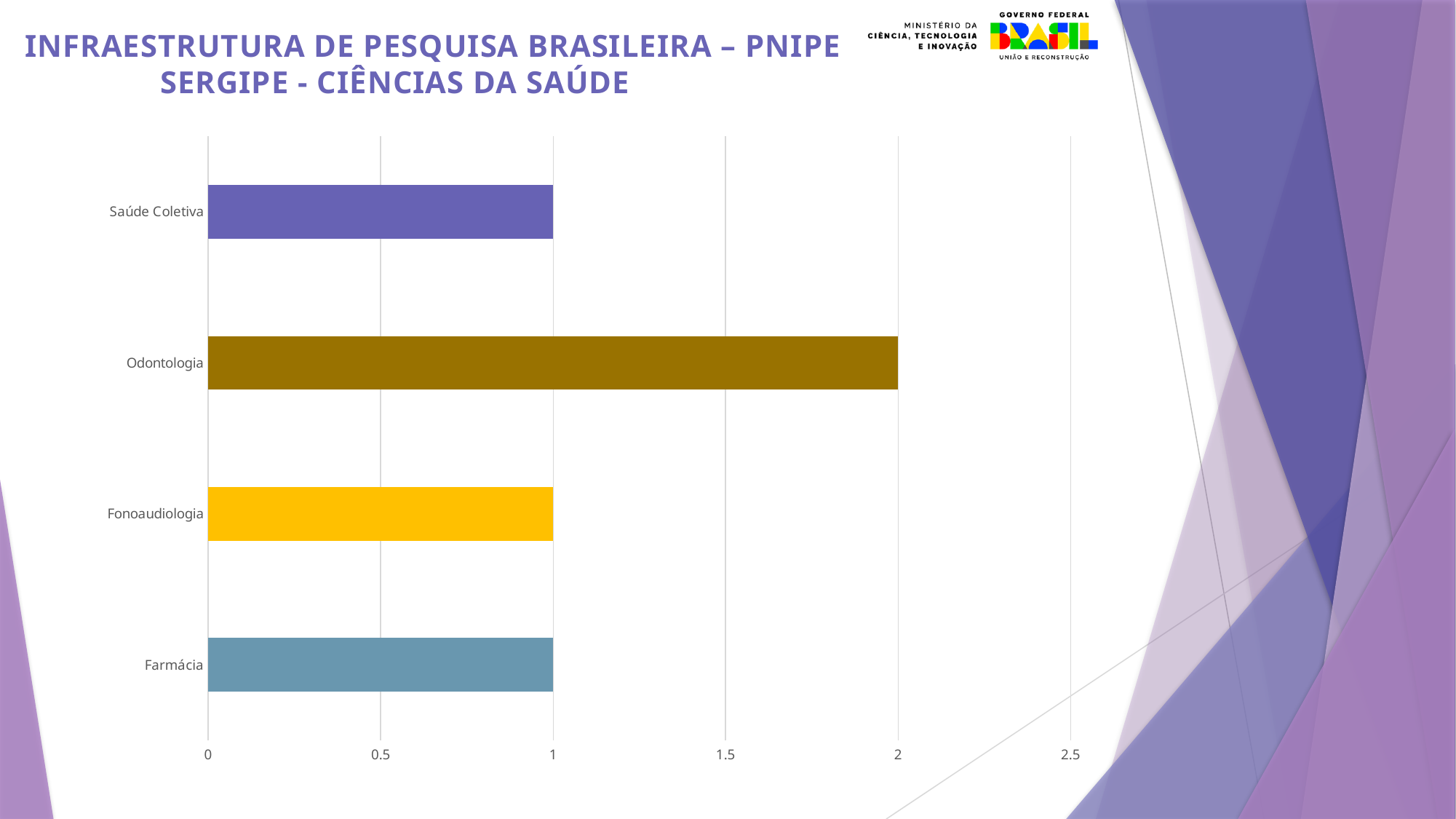
What is the value for Farmácia? 1 What colour is the bar for Fonoaudiologia? Yellow Which is larger, the value for Odontologia or the value for Saúde Coletiva? Odontologia Which category has the highest value? Odontologia Is the value for Fonoaudiologia greater or less than 1.5? less What is the difference between the values for Odontologia and Farmácia? 1 What is the value for Fonoaudiologia? 1 What is the value for Saúde Coletiva? 1 Is the value for Odontologia greater or less than 1.5? greater What kind of chart is shown on the slide? Bar chart How many categories are shown in the chart? 4 What is the value for Odontologia? 2